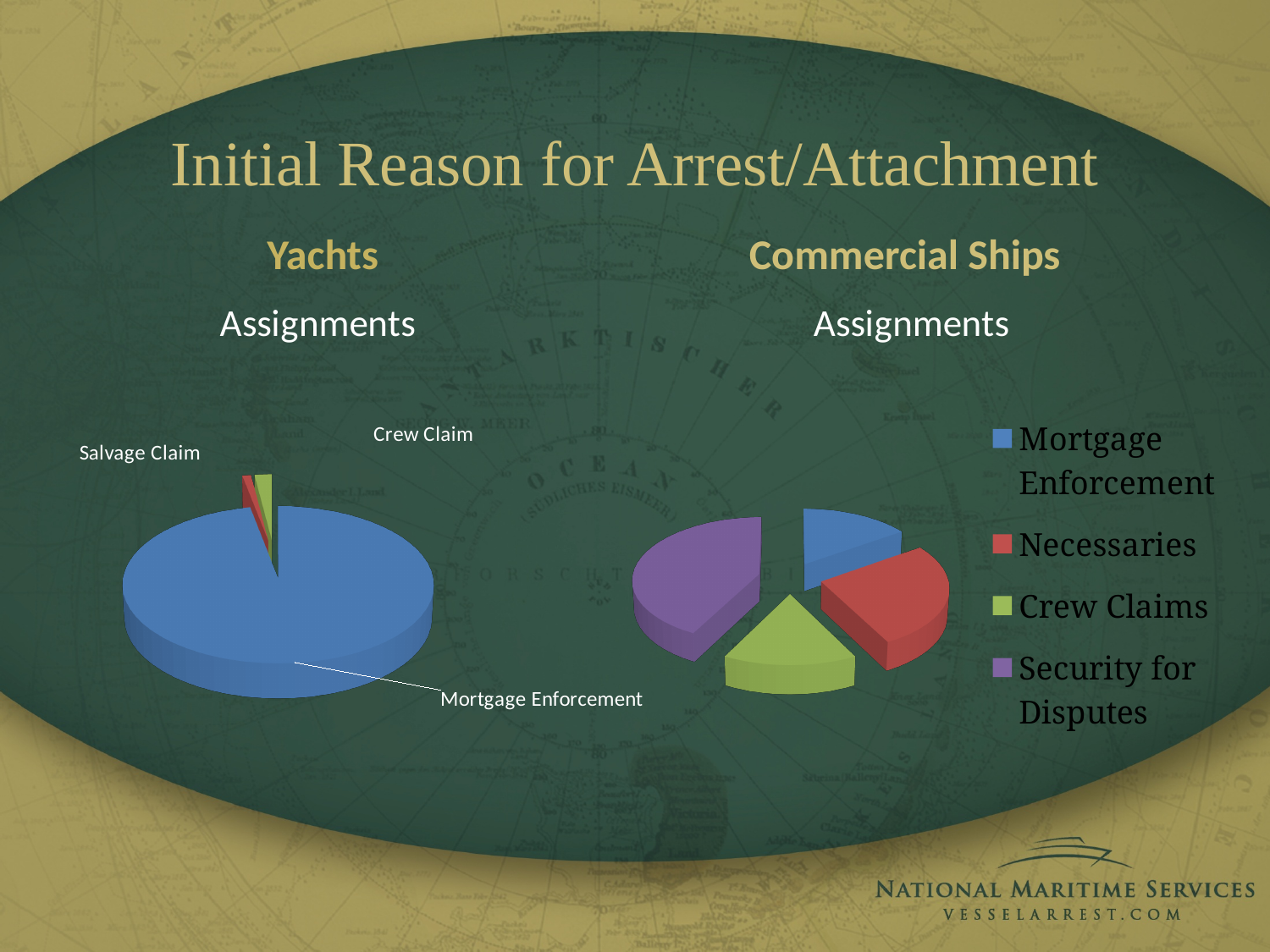
In the Commercial Ships chart, which is larger: Security for Disputes or Crew Claims? Security for Disputes What kind of chart is the Yachts chart? pie chart How many slices does the Commercial Ships pie chart have? 4 In the Commercial Ships chart, what colour represents Mortgage Enforcement? blue How many slices does the Yachts pie chart have? 3 How many entries does the legend of the Commercial Ships chart list? 4 In the Commercial Ships chart, which category has the largest slice? Security for Disputes In the Yachts chart, which category has the largest slice? Mortgage Enforcement What kind of chart is the Commercial Ships chart? pie chart In the Yachts chart, which is larger: Mortgage Enforcement or Crew Claim? Mortgage Enforcement What is the title of the slide containing the two pie charts? Initial Reason for Arrest/Attachment In the Commercial Ships chart, which is larger: Necessaries or Crew Claims? Necessaries